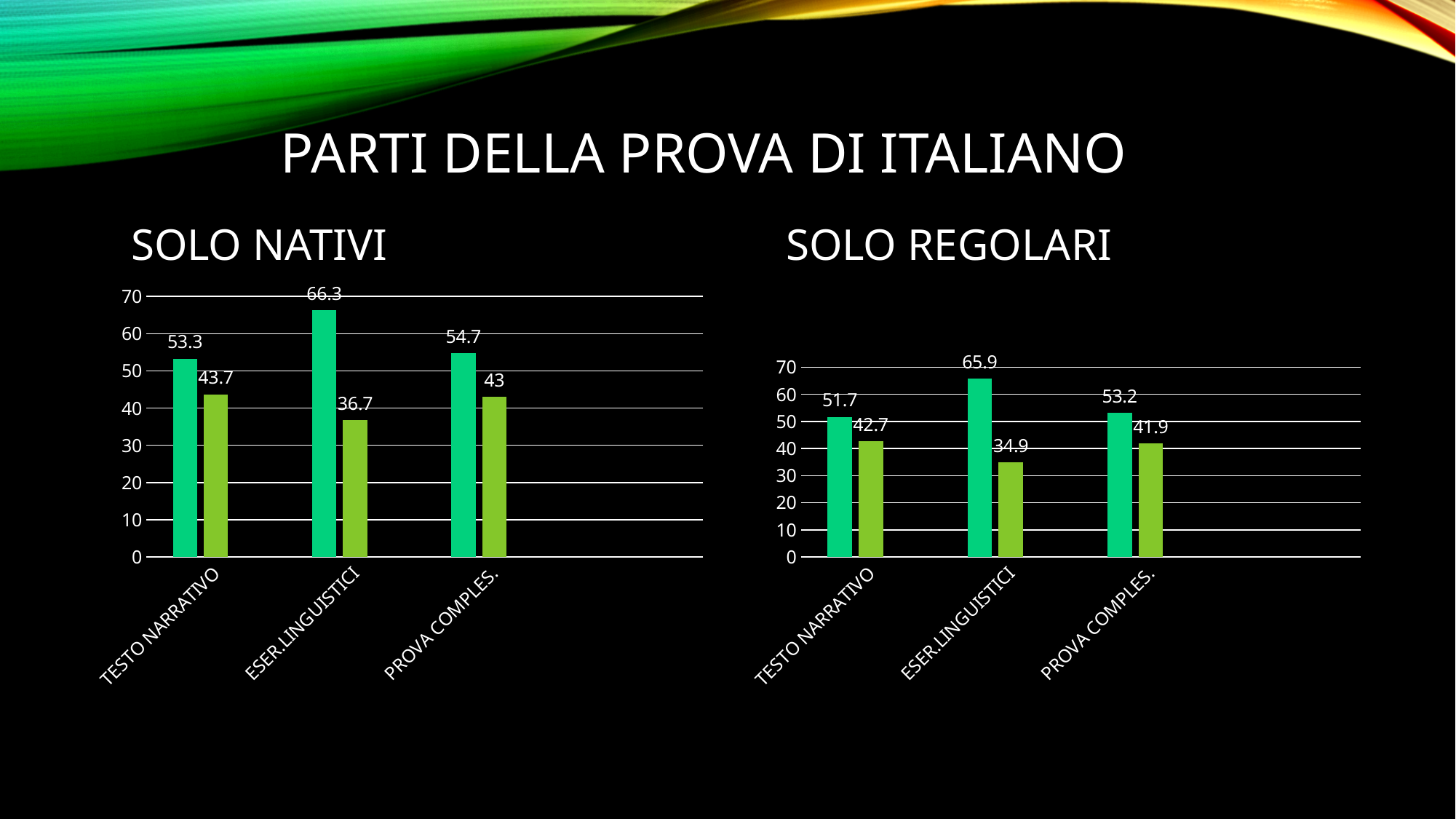
What is the title of the slide? PARTI DELLA PROVA DI ITALIANO What type of chart is the SOLO NATIVI chart? Bar chart In the SOLO NATIVI chart, what is the value of the teal (first) bar for ESER.LINGUISTICI? 66.3 In the SOLO NATIVI chart, what is the value of the light green (second) bar for TESTO NARRATIVO? 43.7 In the SOLO NATIVI chart, which category has the highest teal (first) bar? ESER.LINGUISTICI In the SOLO REGOLARI chart, which category has the lowest light green (second) bar? ESER.LINGUISTICI Which is larger: the teal bar for TESTO NARRATIVO in the SOLO NATIVI chart or the teal bar for TESTO NARRATIVO in the SOLO REGOLARI chart? SOLO NATIVI (53.3) How many categories are shown on the x axis of the SOLO REGOLARI chart? 3 In the SOLO REGOLARI chart, what is the difference between the teal and light green bars for TESTO NARRATIVO? 9 In the SOLO REGOLARI chart, what is the value of the light green (second) bar for ESER.LINGUISTICI? 34.9 In the SOLO REGOLARI chart, what is the value of the teal (first) bar for PROVA COMPLES.? 53.2 In the SOLO NATIVI chart, what is the difference between the teal and light green bars for ESER.LINGUISTICI? 29.6